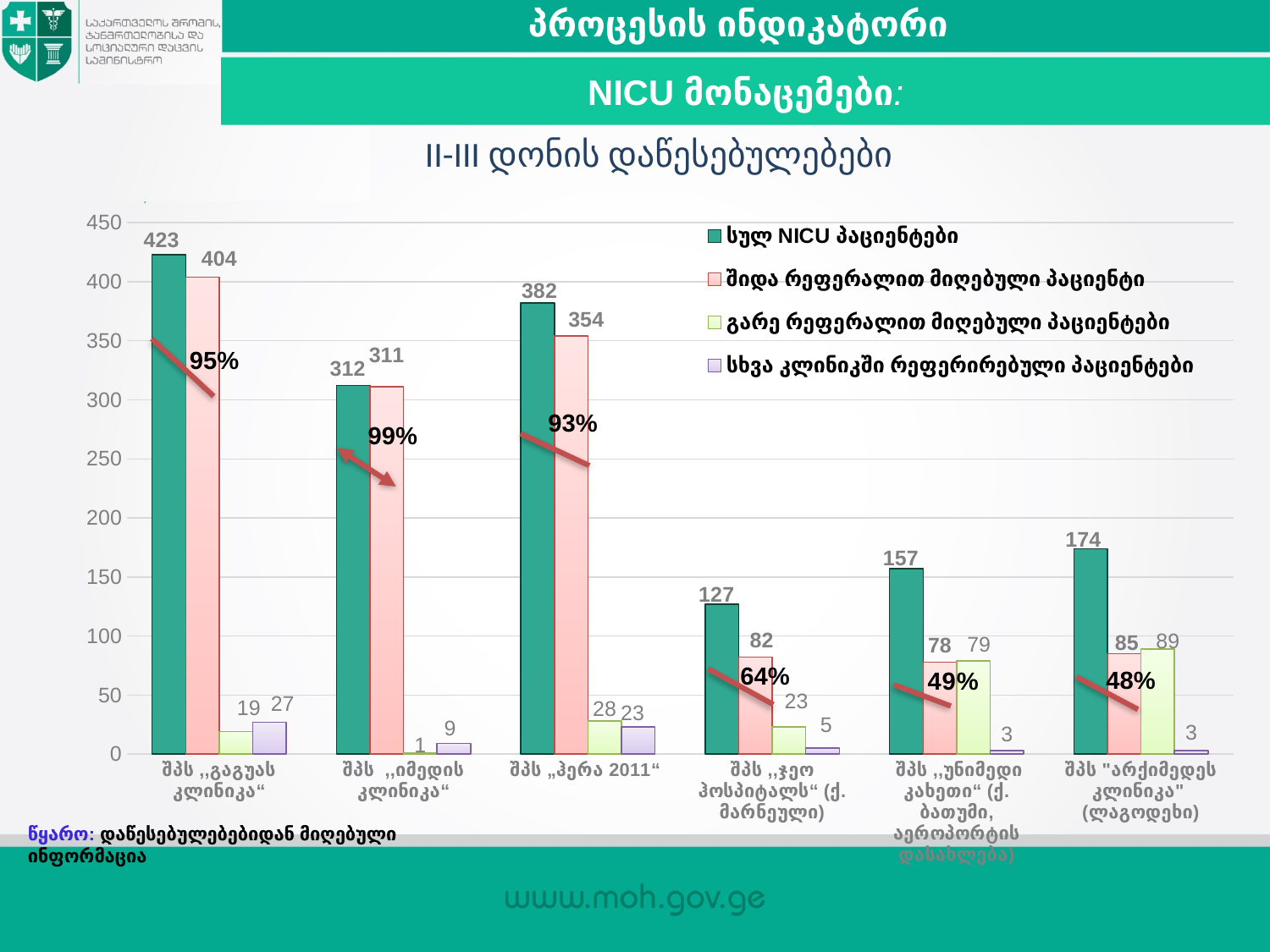
What is the value of სულ NICU პაციენტები for შპს „გაგუას კლინიკა"? 423 What is the value of გარე რეფერალით მიღებული პაციენტები for შპს „უნიმედი კახეთი"? 79 Which clinic has the lowest value for სულ NICU პაციენტები? შპს „ჯეო ჰოსპიტალს" (ქ. მარნეული) How many series does the legend list? 4 How many clinics (categories) are shown on the x axis? 6 Which is larger for შპს "არქიმედეს კლინიკა": შიდა რეფერალით მიღებული პაციენტი or გარე რეფერალით მიღებული პაციენტები? გარე რეფერალით მიღებული პაციენტები What percentage is annotated above the bars for შპს „იმედის კლინიკა"? 99% What is the value of სხვა კლინიკაში რეფერირებული პაციენტები for შპს „იმედის კლინიკა"? 9 Which clinic has the highest value for სულ NICU პაციენტები? შპს „გაგუას კლინიკა" What is the difference between სულ NICU პაციენტები and შიდა რეფერალით მიღებული პაციენტი for შპს „ჯეო ჰოსპიტალს"? 45 What type of chart is shown on the slide? bar chart What is the value of შიდა რეფერალით მიღებული პაციენტი for შპს „ჰერა 2011"? 354